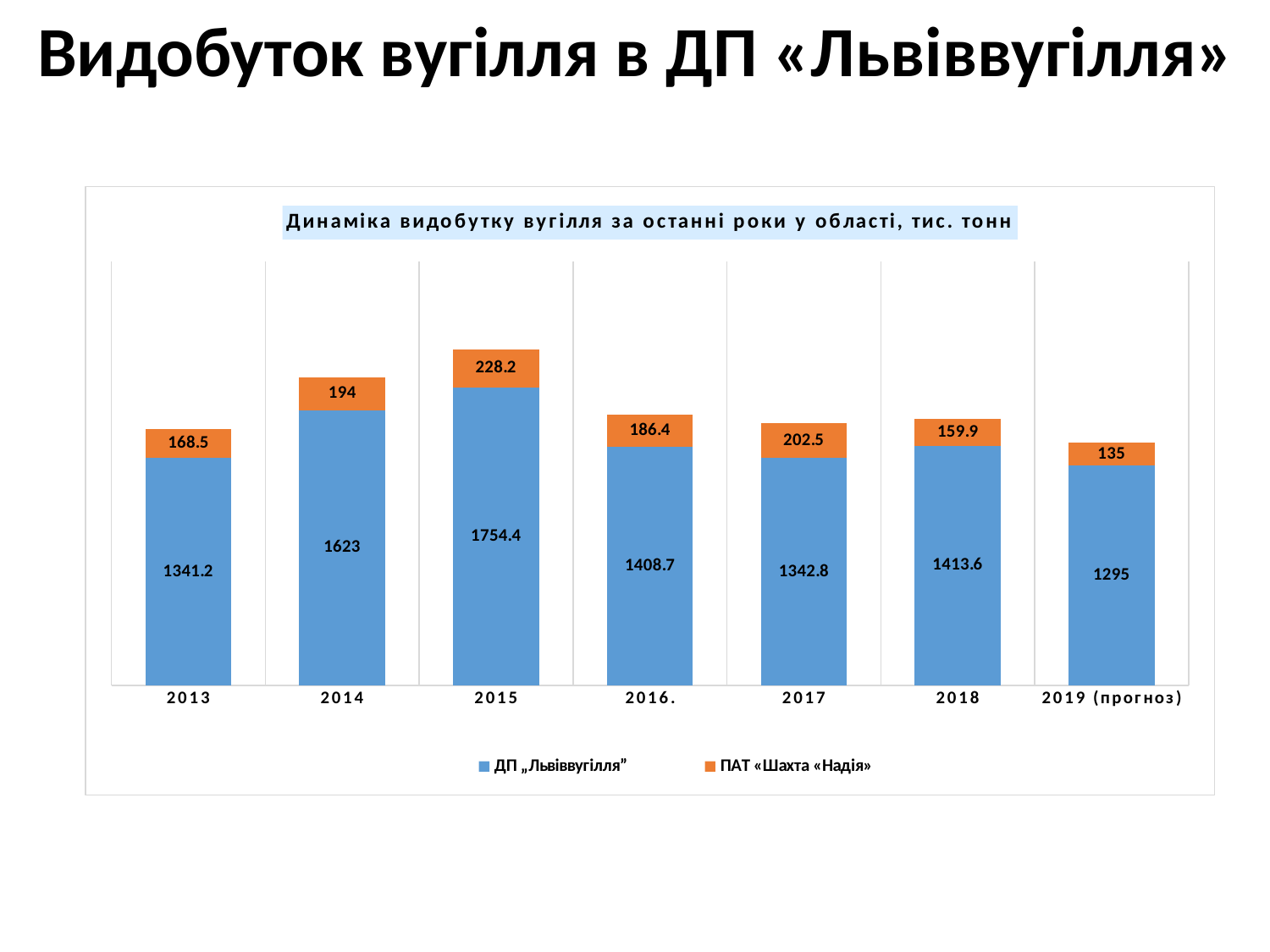
What is the difference between the ДП „Львіввугілля” values for 2015 and 2014? 131.4 What is the value for ДП „Львіввугілля” in 2015? 1754.4 Which is larger: the ПАТ «Шахта «Надія» value in 2014 or in 2018? 2014 What is the value for ПАТ «Шахта «Надія» in 2017? 202.5 How many series does the legend list? 2 Which colour represents ПАТ «Шахта «Надія» in the chart? Orange In which year is the value for ДП „Львіввугілля” the highest? 2015 What is the total of the stacked bar for 2015? 1982.6 What is the value for ДП „Львіввугілля” in 2019 (прогноз)? 1295 What kind of chart is shown on the slide? Stacked bar chart How many years are shown on the x axis? 7 In which year is the value for ПАТ «Шахта «Надія» the lowest? 2019 (прогноз)